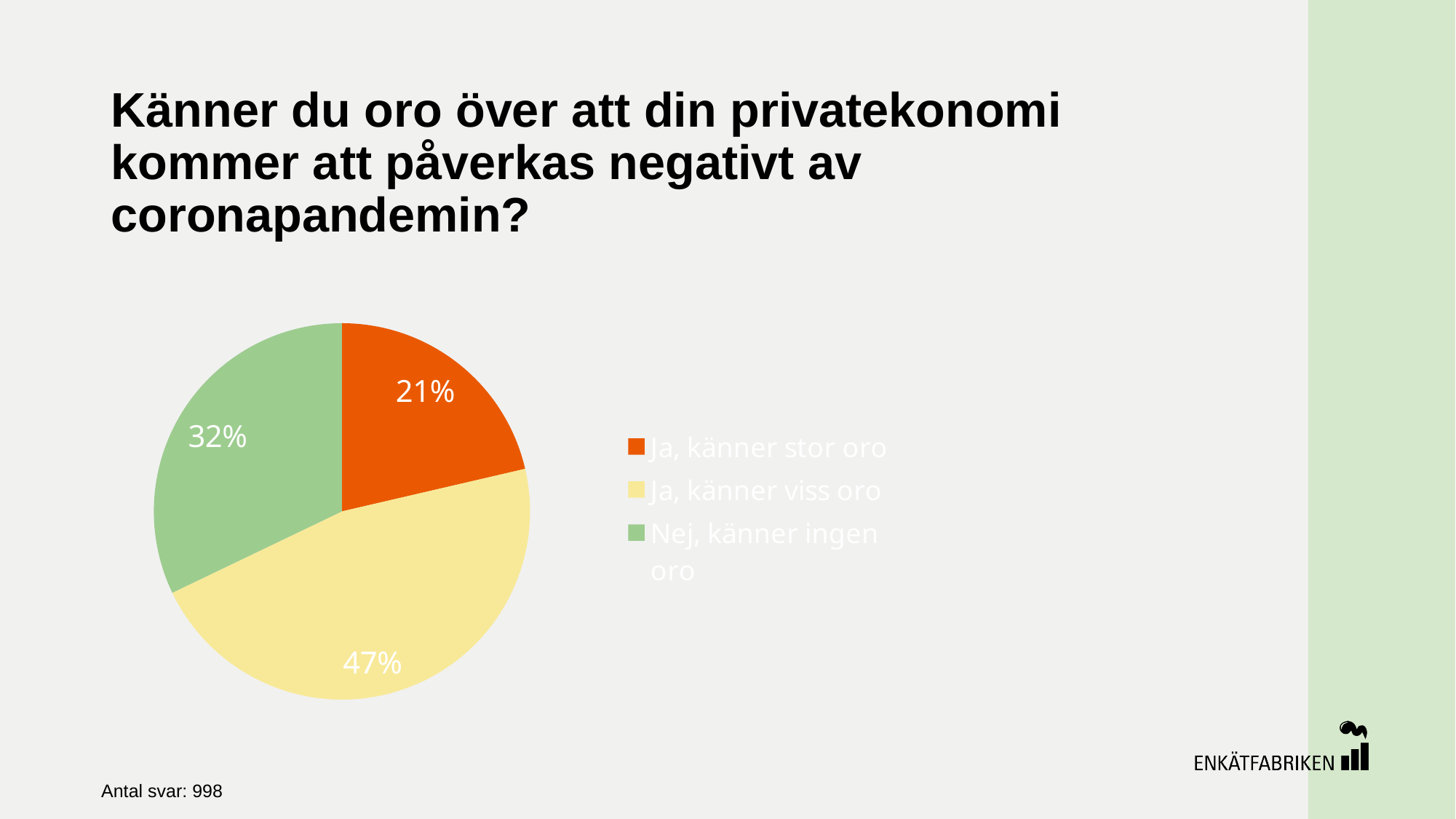
What kind of chart is shown on the slide? Pie chart What share of respondents answered "Ja, känner stor oro"? 21% What is the difference in percentage points between "Ja, känner viss oro" and "Nej, känner ingen oro"? 15 What share of respondents answered "Nej, känner ingen oro"? 32% What colour is the slice for "Ja, känner viss oro"? Yellow Which response has the largest share of the pie? Ja, känner viss oro How many slices does the pie chart have? 3 Which response has the smallest share of the pie? Ja, känner stor oro How many responses (Antal svar) does the slide report? 998 How many entries does the legend list? 3 What share of respondents answered "Ja, känner viss oro"? 47% Which is larger: the share for "Nej, känner ingen oro" or the share for "Ja, känner stor oro"? Nej, känner ingen oro